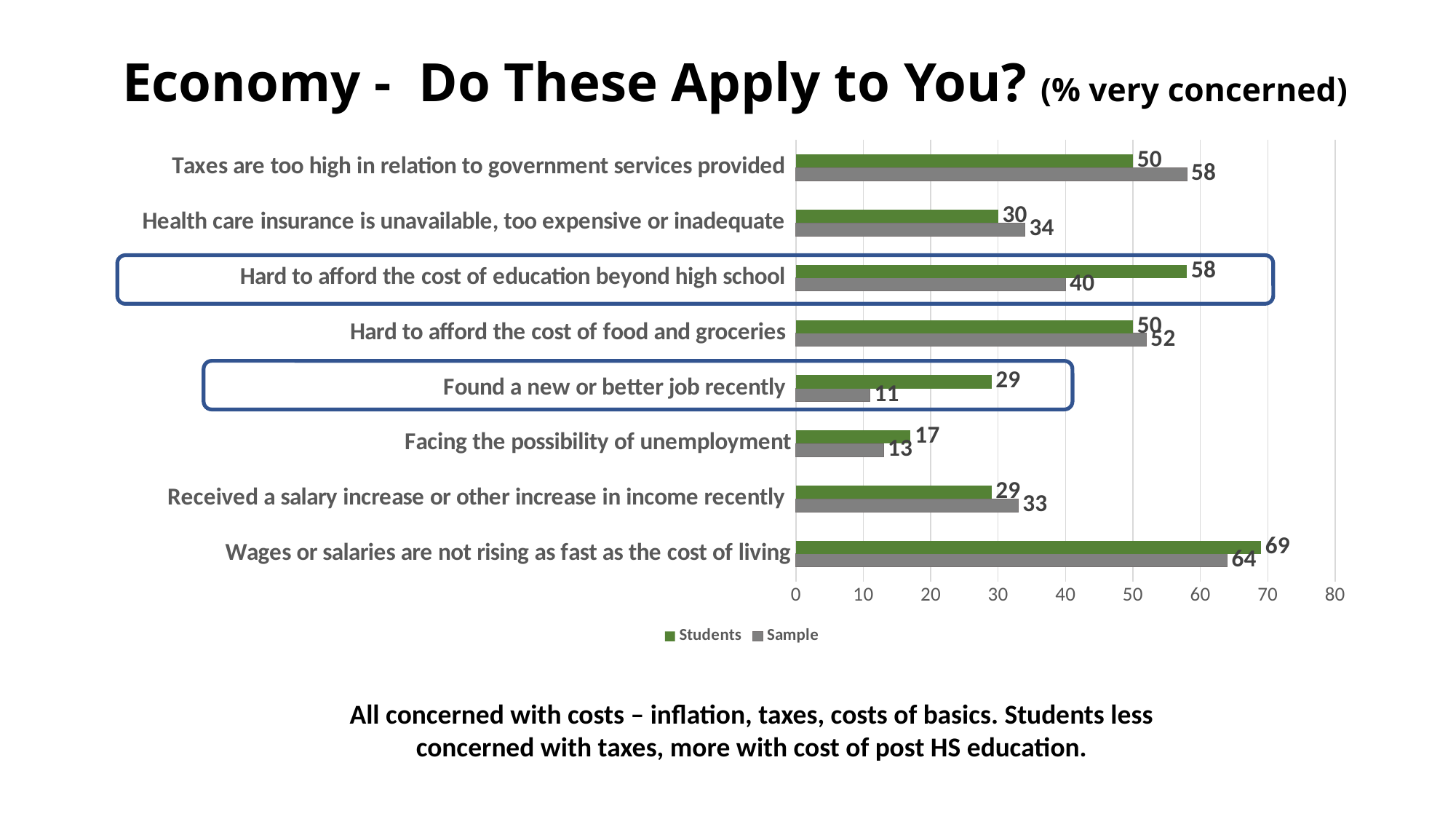
What is the difference between the Students and Sample values for "Hard to afford the cost of education beyond high school"? 18 What is the difference between the Students and Sample values for "Found a new or better job recently"? 18 For "Taxes are too high in relation to government services provided", which is larger, the Students value or the Sample value? Sample What kind of chart is shown on the slide? Bar chart What is the Students value for "Hard to afford the cost of education beyond high school"? 58 Which category has the highest Students value? Wages or salaries are not rising as fast as the cost of living Which category has the lowest Sample value? Found a new or better job recently How many series does the legend list? 2 What is the Sample value for "Found a new or better job recently"? 11 For "Wages or salaries are not rising as fast as the cost of living", which is larger, the Students value or the Sample value? Students How many categories are shown on the chart? 8 What is the Sample value for "Taxes are too high in relation to government services provided"? 58